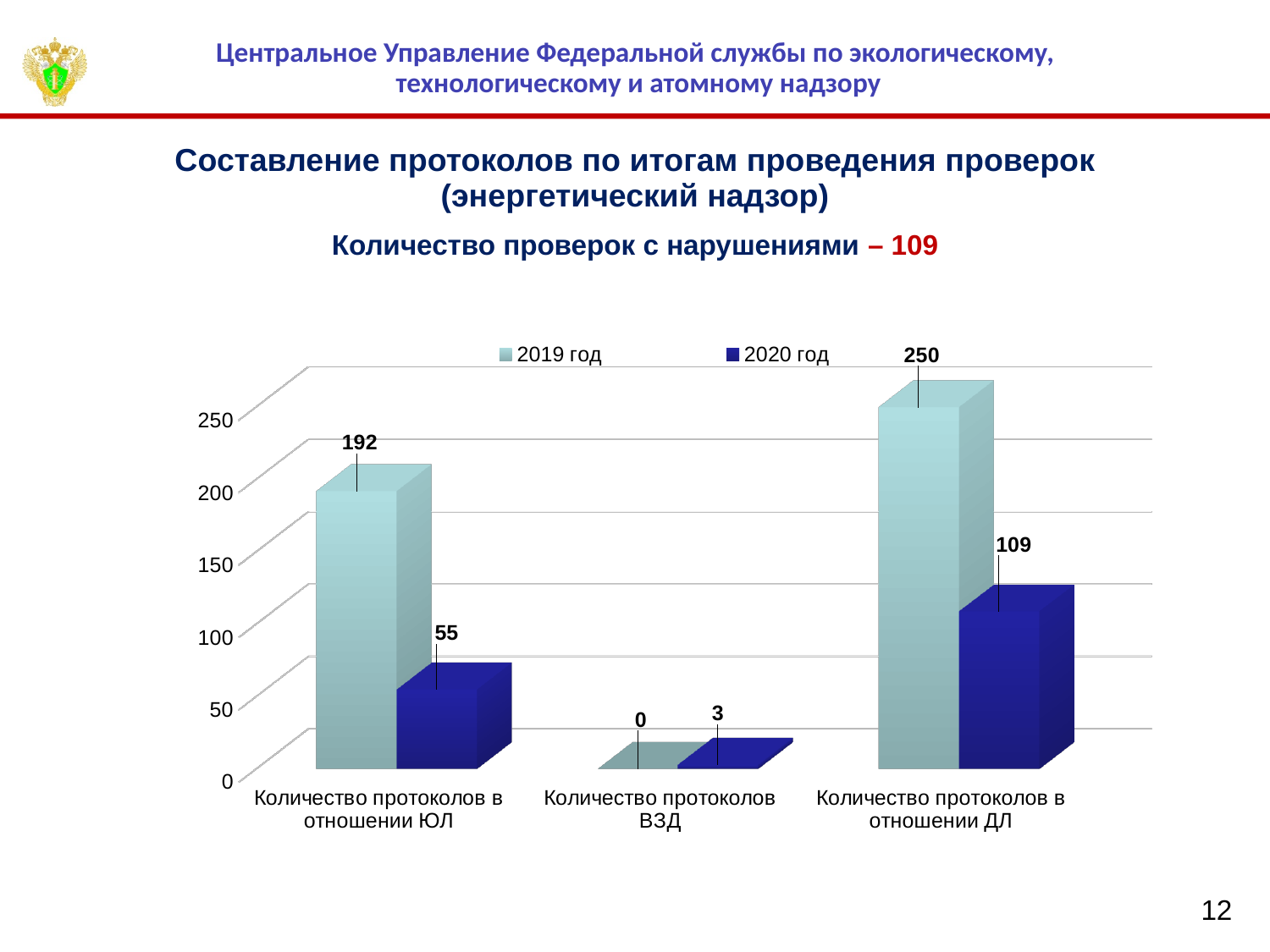
How many series does the legend list? 2 What is the value for 'Количество протоколов в отношении ЮЛ' in the 2020 год series? 55 What is the value for 'Количество протоколов ВЗД' in the 2020 год series? 3 What is the value for 'Количество протоколов ВЗД' in the 2019 год series? 0 Which category has the highest value in the 2019 год series? Количество протоколов в отношении ДЛ What is the value for 'Количество протоколов в отношении ЮЛ' in the 2019 год series? 192 Which category has the lowest value in the 2020 год series? Количество протоколов ВЗД What is the value for 'Количество протоколов в отношении ДЛ' in the 2019 год series? 250 How many categories are shown on the x axis? 3 What kind of chart is shown on the slide? bar chart What is the difference between the 2019 год and 2020 год values for 'Количество протоколов в отношении ДЛ'? 141 Which is larger for 'Количество протоколов в отношении ЮЛ': the 2019 год value or the 2020 год value? 2019 год